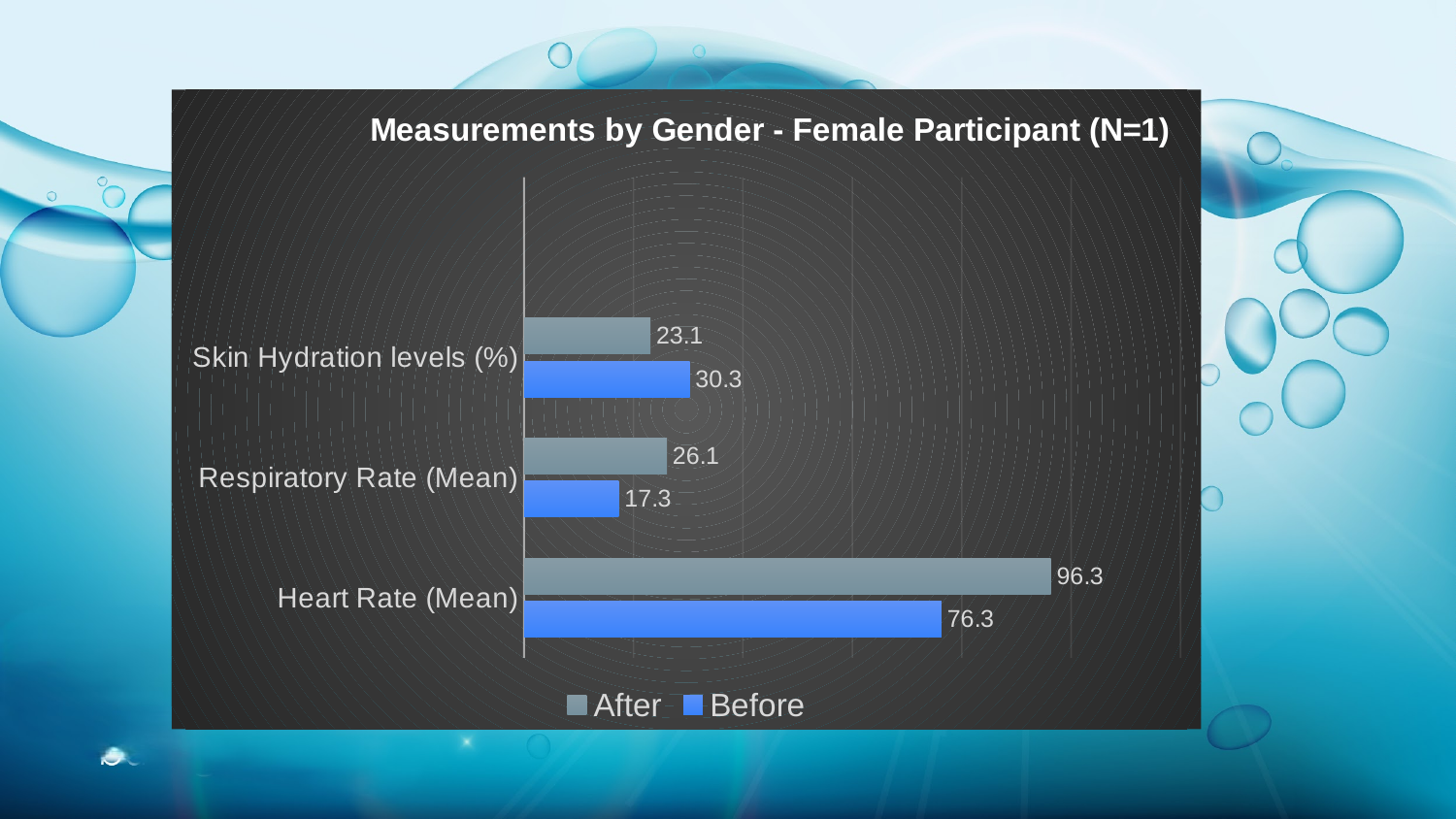
What is the difference between the After and Before values for Heart Rate (Mean)? 20.0 What kind of chart is shown on the slide? Bar chart What is the After value for Heart Rate (Mean)? 96.3 What is the After value for Skin Hydration levels (%)? 23.1 What is the Before value for Respiratory Rate (Mean)? 17.3 How many categories are shown on the chart? 3 Which category has the highest After value? Heart Rate (Mean) What is the difference between the Before and After values for Skin Hydration levels (%)? 7.2 Which category has the lowest Before value? Respiratory Rate (Mean) What is the Before value for Skin Hydration levels (%)? 30.3 For Respiratory Rate (Mean), which is larger, the After value or the Before value? After How many series does the legend list? 2